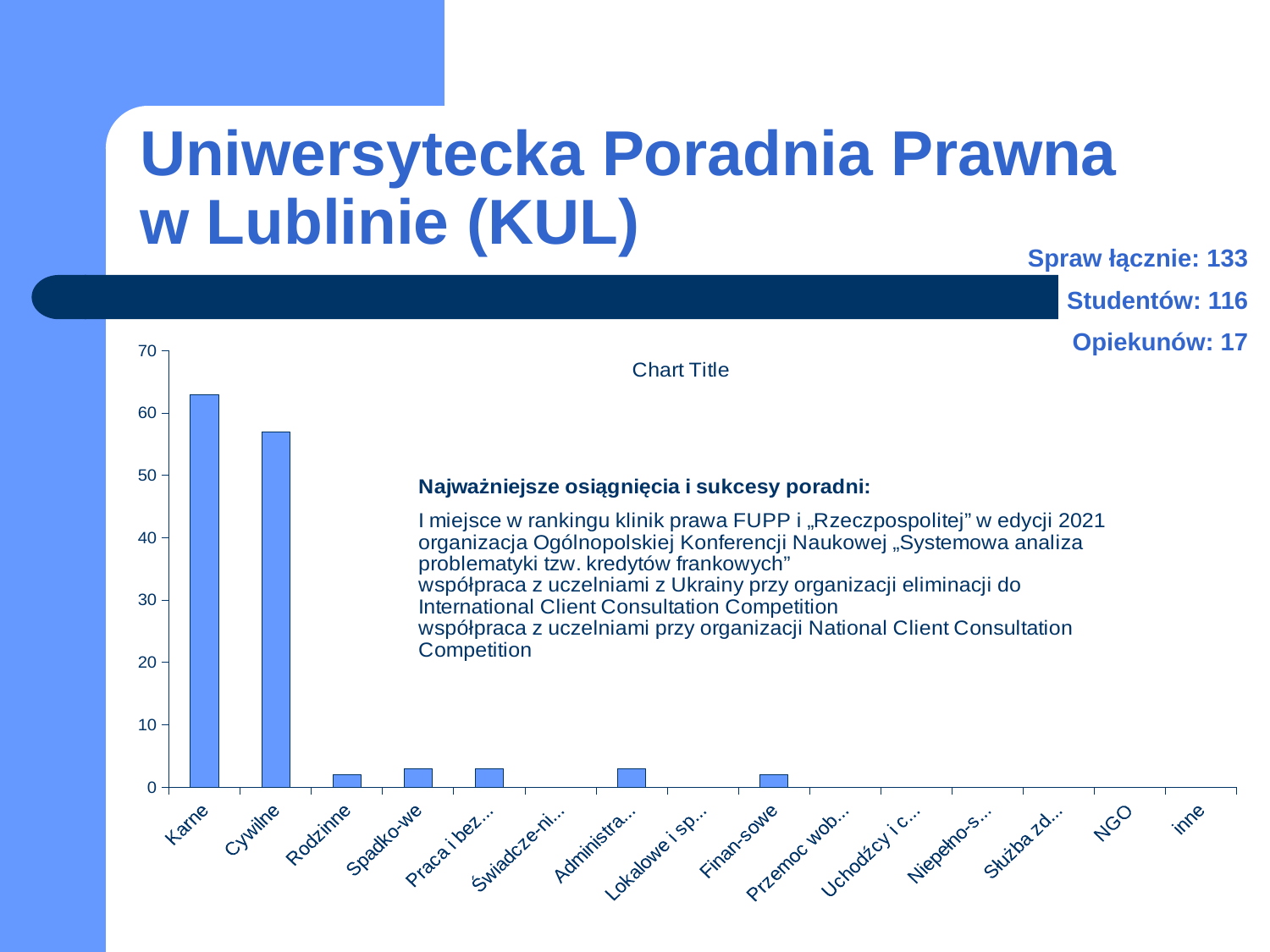
Which is larger, the value for Cywilne or the value for Rodzinne? Cywilne How many categories are shown on the x axis of the chart? 15 Is the value for Cywilne greater or less than 50? greater Which is larger, the value for Karne or the value for Cywilne? Karne Is the value for Spadko-we greater or less than 10? less Is the value for Karne greater or less than 60? greater What is the title shown on the chart? Chart Title What kind of chart is shown on the slide? bar chart Which category has the highest bar in the chart? Karne